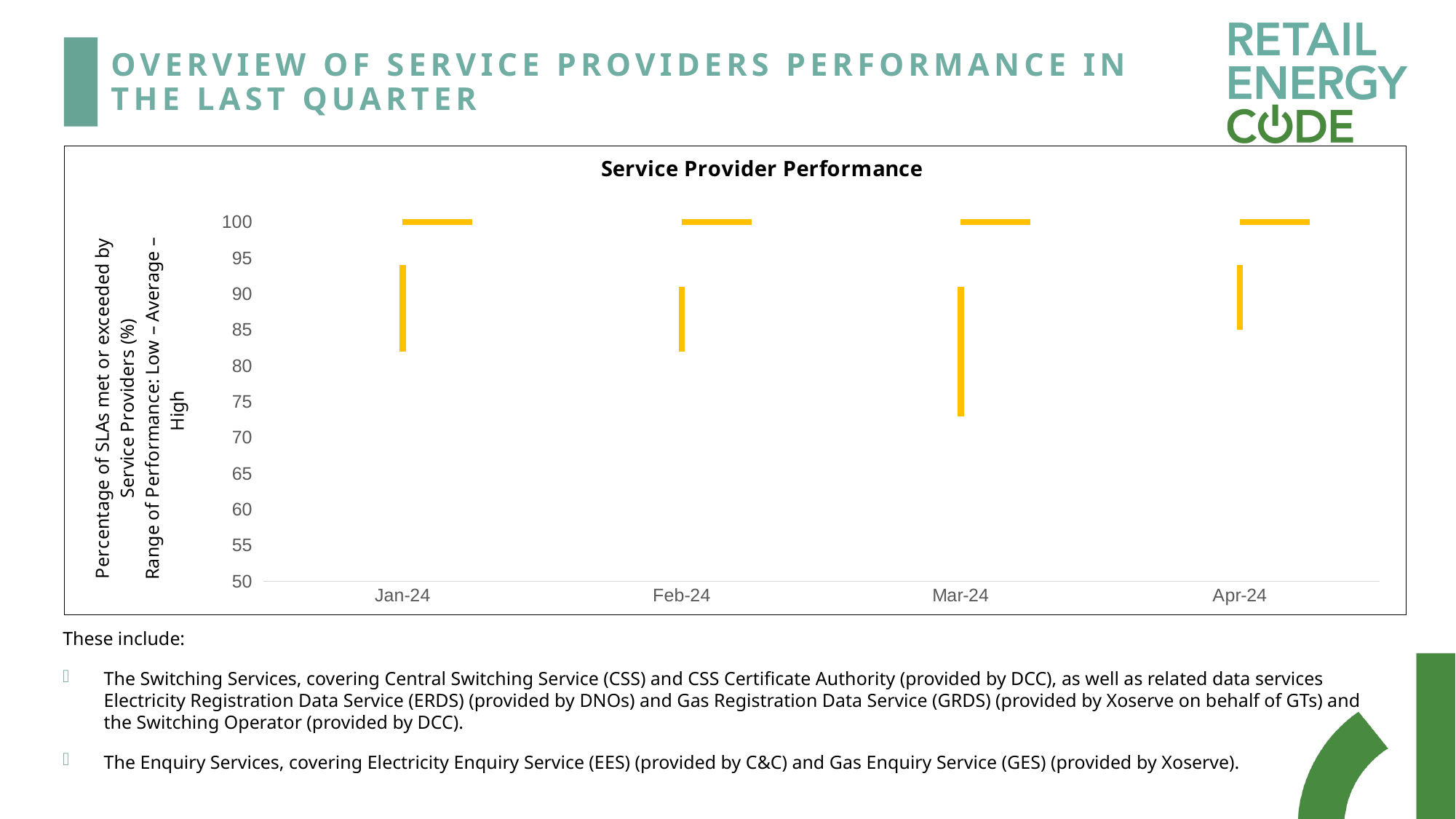
What is the high value marked for Apr-24? 100 Which month has the lowest low value in the performance range? Mar-24 What is the lowest value shown on the y axis of the chart? 50 What is the first month shown on the x axis? Jan-24 Is the low value of the range for Apr-24 greater or less than 80? greater How many months are shown on the x axis of the chart? 4 Is the low value of the range for Mar-24 greater or less than 75? less Is the low value of the range for Feb-24 greater or less than 85? less What is the high value marked for Jan-24? 100 Which month has a higher low value in the performance range, Apr-24 or Mar-24? Apr-24 What is the title of the chart? Service Provider Performance